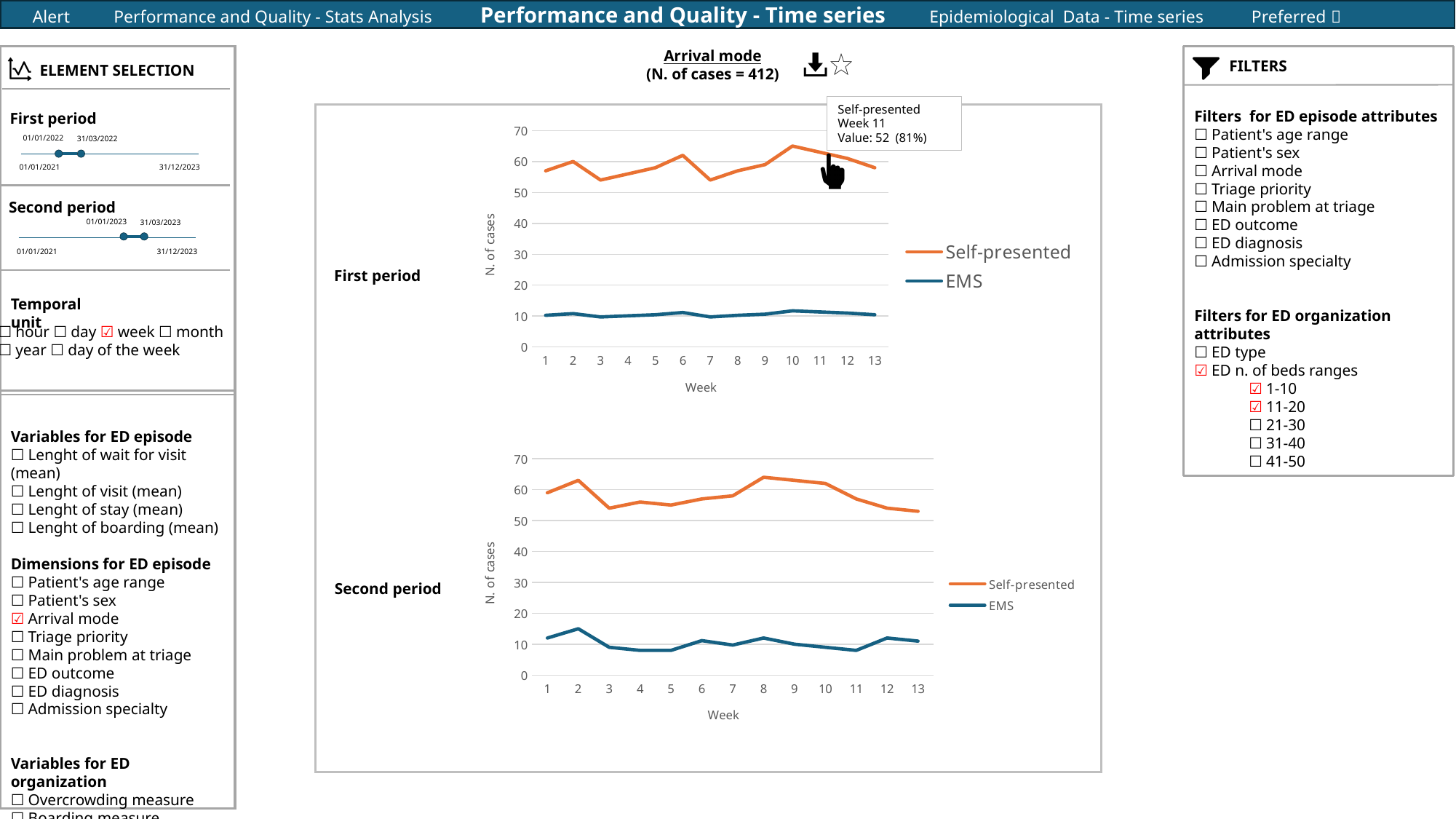
How many series does the legend of the First period chart list? 2 In the Second period chart, which series has the larger value at week 8, Self-presented or EMS? Self-presented How many weeks are plotted along the x axis of the Second period chart? 13 In the Second period chart, at which week does the EMS series reach its highest value? 2 In the First period chart, is the Self-presented value at week 10 greater or less than 60? greater In the Second period chart, does the Self-presented series rise or fall from week 9 to week 13? fall In the First period chart, is the EMS value at week 1 greater or less than 20? less In the First period chart, what percentage is shown in the tooltip for Self-presented at Week 11? 81% What is the y-axis label of the charts? N. of cases What type of chart is used for the First period panel? line chart In the First period chart, what is the Self-presented value at Week 11 shown in the tooltip? 52 In the First period chart, at which week does the Self-presented series reach its highest value? 10